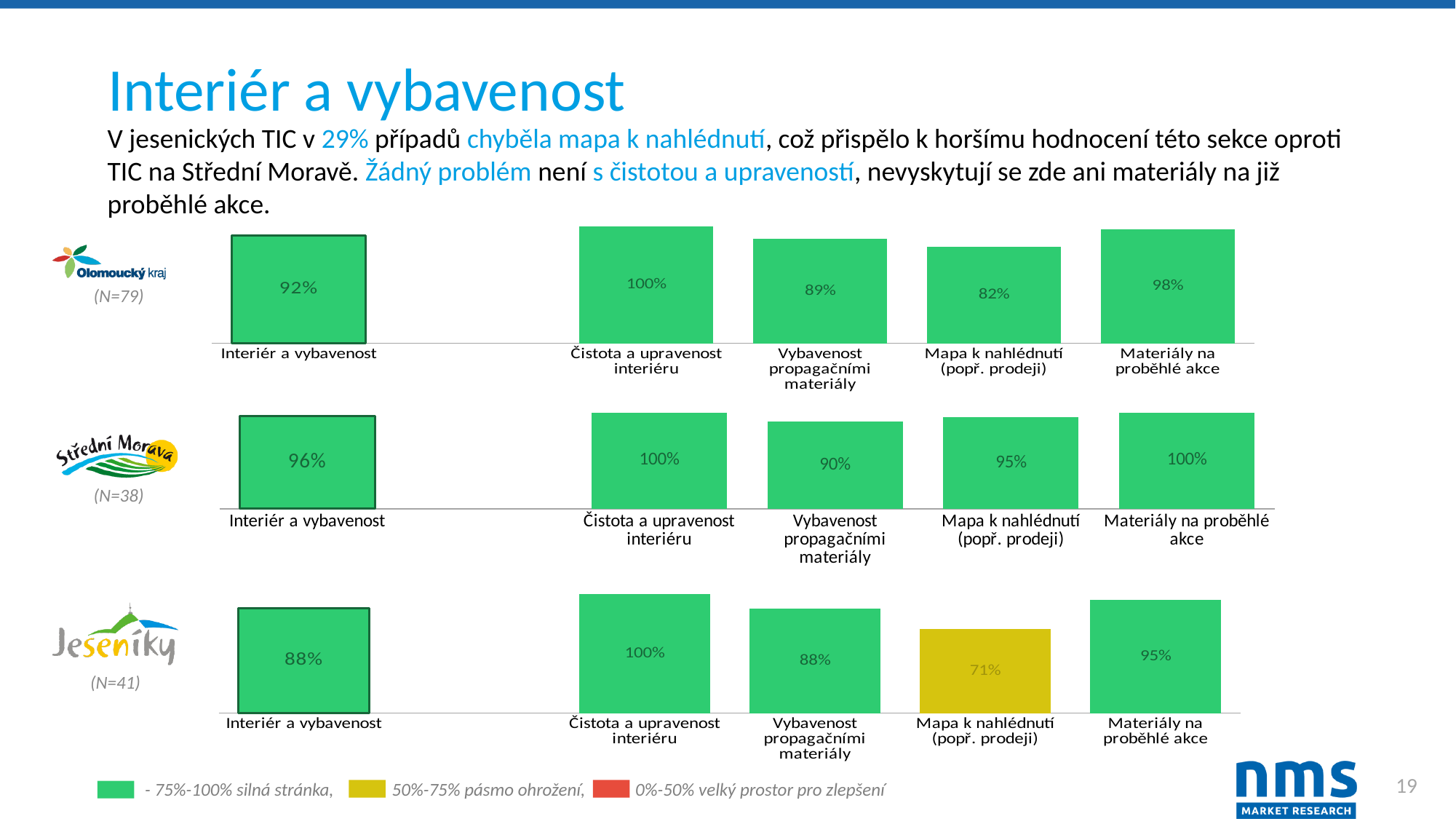
In the Jeseníky chart, which bar is coloured yellow instead of green? Mapa k nahlédnutí (popř. prodeji) In the Olomoucký kraj chart, which category has the highest value? Čistota a upravenost interiéru What type of chart is used for the Olomoucký kraj data? Bar chart In the Olomoucký kraj chart, what is the value for Mapa k nahlédnutí (popř. prodeji)? 82% Which is larger: the Interiér a vybavenost value in the Střední Morava chart or in the Jeseníky chart? Střední Morava In the Jeseníky chart, what is the difference between Čistota a upravenost interiéru and Mapa k nahlédnutí (popř. prodeji)? 29% How many categories are shown in the Střední Morava chart? 5 What is the sample size (N) shown for the Střední Morava chart? N=38 In the Jeseníky chart, what is the value for Materiály na proběhlé akce? 95% In the Střední Morava chart, what is the value for Vybavenost propagačními materiály? 90% In the Olomoucký kraj chart, what is the difference between Materiály na proběhlé akce and Mapa k nahlédnutí (popř. prodeji)? 16% In the Jeseníky chart, which category has the lowest value? Mapa k nahlédnutí (popř. prodeji)